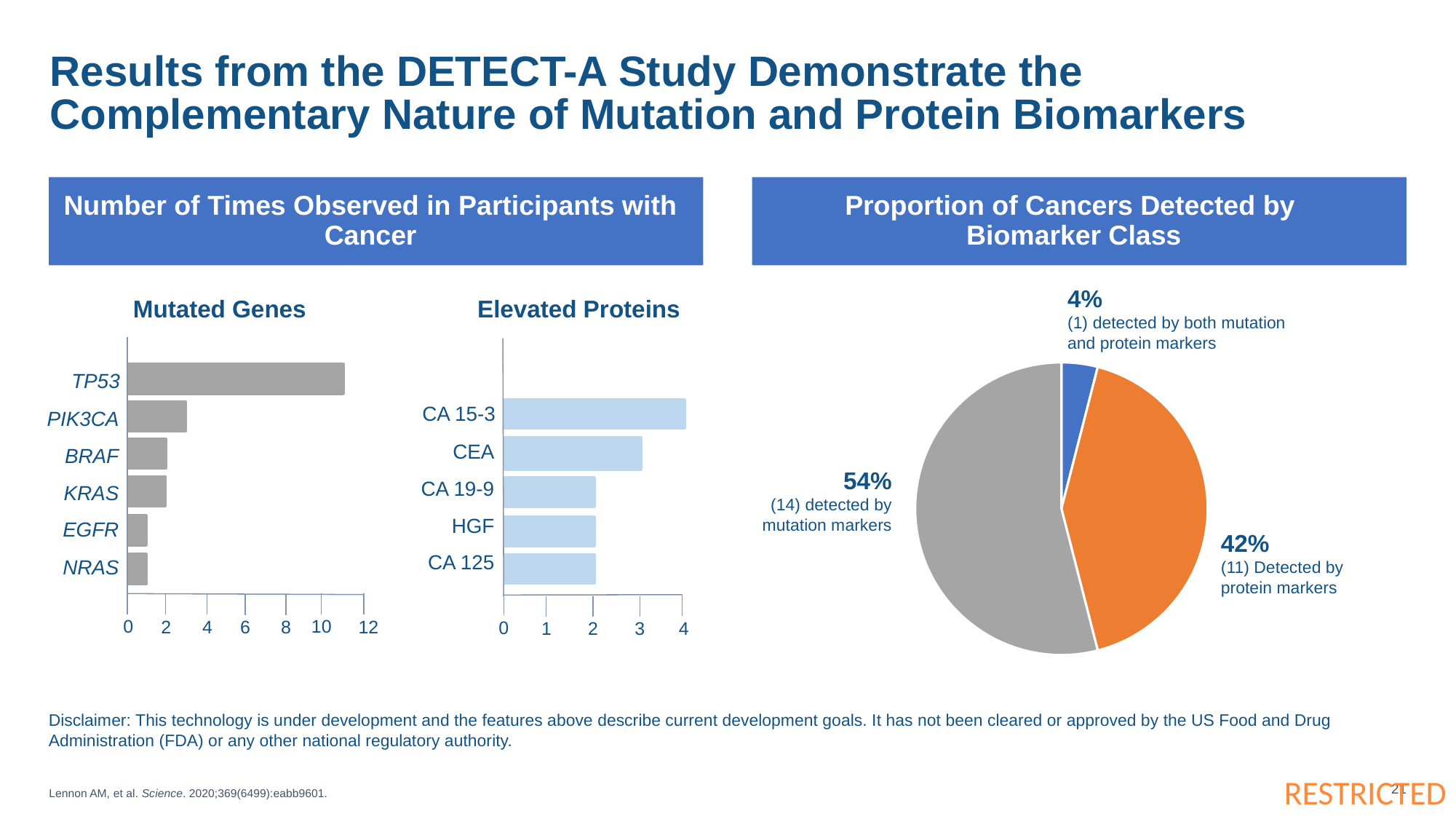
In the Elevated Proteins chart, what is the value for CEA? 3 What kind of chart is the Elevated Proteins chart? Bar chart In the Proportion of Cancers Detected by Biomarker Class pie chart, which slice is the smallest? Detected by both mutation and protein markers (4%) In the Elevated Proteins chart, how many proteins are listed? 5 In the Mutated Genes chart, which gene has the highest number of times observed? TP53 In the Mutated Genes chart, which is larger, the value for TP53 or the value for PIK3CA? TP53 In the Proportion of Cancers Detected by Biomarker Class pie chart, what share of cancers was detected by protein markers? 42% In the Mutated Genes chart, is the value for PIK3CA greater or less than 2? greater In the Elevated Proteins chart, what is the difference between the values for CA 15-3 and CA 125? 2 In the Elevated Proteins chart, what is the value for CA 15-3? 4 In the Mutated Genes chart, how many genes are listed? 6 In the Mutated Genes chart, is the value for TP53 greater or less than 10? greater